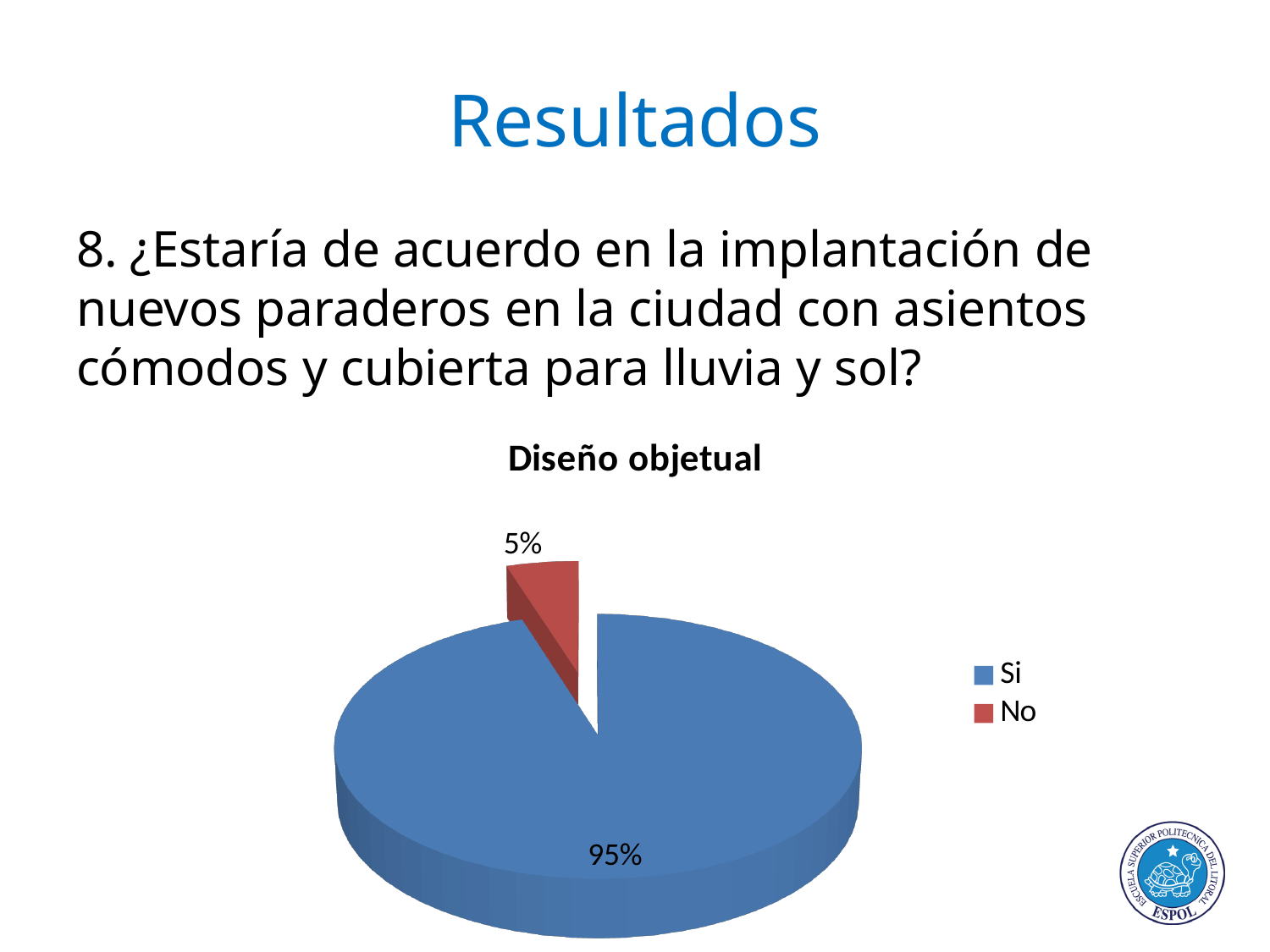
What is the difference in percentage points between the "Si" and "No" slices? 90 What percentage of the pie corresponds to "Si"? 95% What share of the pie does the "Si" slice represent? 95% What colour is the "No" slice? red What kind of chart is shown on the slide? pie chart Which category has the smallest share of the pie? No Which category has the largest share of the pie? Si What is the title of the chart? Diseño objetual Which is larger, the "Si" slice or the "No" slice? Si How many categories does the legend list? 2 What percentage of the pie corresponds to "No"? 5%